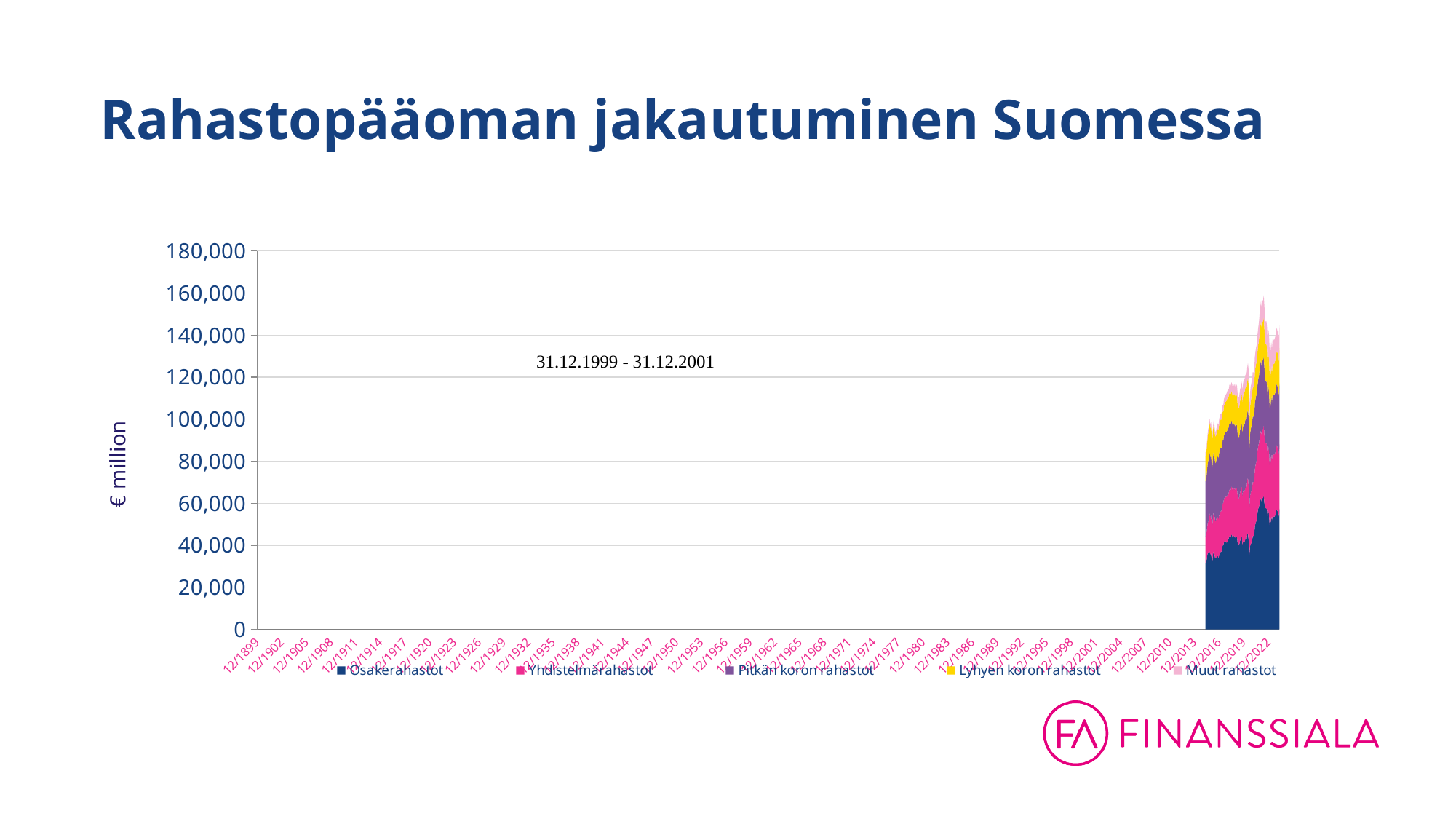
What is the title of the chart on the slide? Rahastopääoman jakautuminen Suomessa Is the value of the Osakerahastot series at the end of the chart greater or less than 80,000? less Is the total stacked value at the end of the series (12/2022) greater or less than 120,000? greater What is the label of the vertical axis? € million Which series is plotted at the bottom of the stack? Osakerahastot Is the total stacked value at the start of the plotted data (around 12/2016) greater or less than 120,000? less Does the total stacked value generally rise or fall from the start of the plotted data to its peak? rise Which series is plotted at the top of the stack? Muut rahastot How many series does the legend list? 5 What kind of chart is shown on the slide? Stacked area chart What is the highest value shown on the vertical axis? 180,000